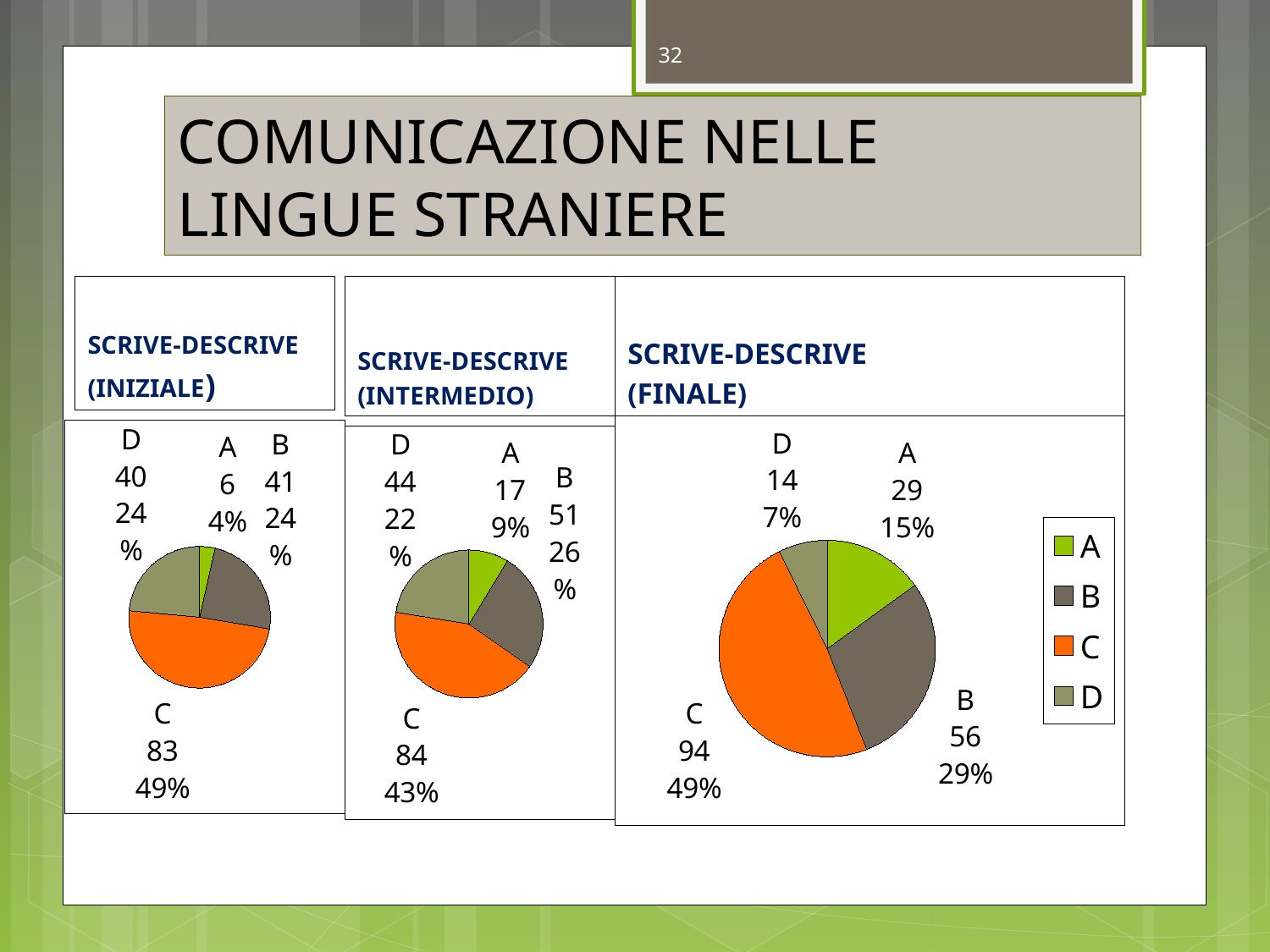
In the SCRIVE-DESCRIVE (FINALE) chart, what is the difference between the values for C and B? 38 How many categories does the SCRIVE-DESCRIVE (INIZIALE) pie chart have? 4 How many entries does the legend next to the SCRIVE-DESCRIVE (FINALE) chart list? 4 What kind of chart is used in the SCRIVE-DESCRIVE (FINALE) panel? pie chart In the SCRIVE-DESCRIVE (INIZIALE) chart, what percentage share does category A have? 4% In the SCRIVE-DESCRIVE (FINALE) chart, what is the value for category A? 29 In the SCRIVE-DESCRIVE (INTERMEDIO) chart, which is larger, the value for B or the value for D? B In the SCRIVE-DESCRIVE (INTERMEDIO) chart, what percentage share does category D have? 22% In the SCRIVE-DESCRIVE (INIZIALE) chart, what is the value for category C? 83 In the SCRIVE-DESCRIVE (INTERMEDIO) chart, what is the value for category B? 51 In the SCRIVE-DESCRIVE (FINALE) chart, which category has the largest slice? C In the SCRIVE-DESCRIVE (FINALE) chart, which category has the smallest slice? D